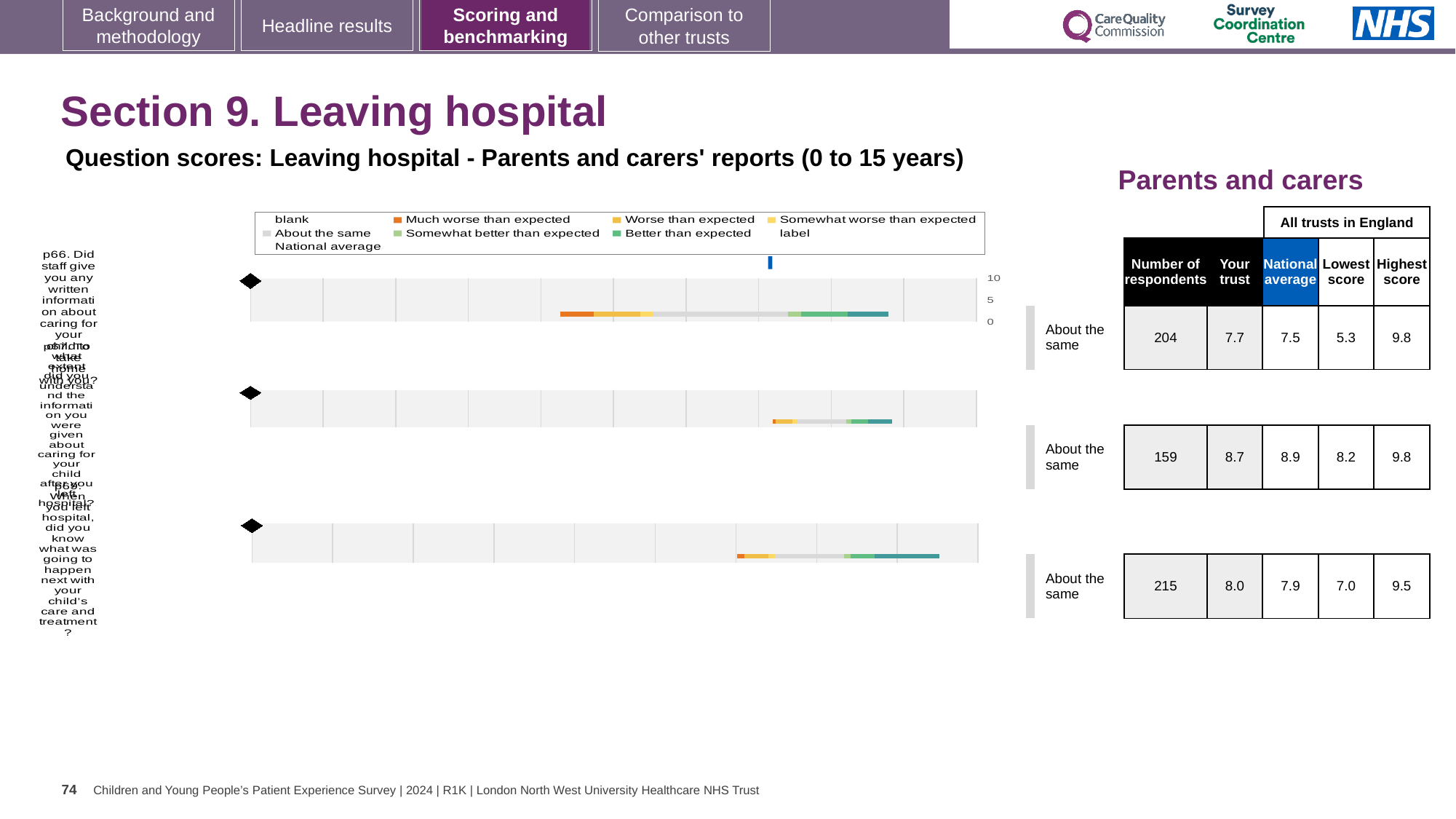
In the legend, which category is shown in orange? Much worse than expected In the table, which question has the highest 'Your trust' score? the second question (8.7) In the table, what is the number of respondents for the first question (p66)? 204 In the table, what is the national average for the second question? 8.9 In the table, what is the highest score for the third question (p68)? 9.5 What kind of chart is used to show the question scores on this slide? bar chart In the table, which question has the lowest 'Lowest score' value? the first question, p66 (5.3) How many question score charts are shown on the slide? 3 In the table, what is the difference between the 'Your trust' score and the national average for the third question (p68)? 0.1 What benchmark category is shown for all three questions? About the same In the table, what is the 'Your trust' score for the first question (p66)? 7.7 In the legend, which category is shown in light grey? About the same